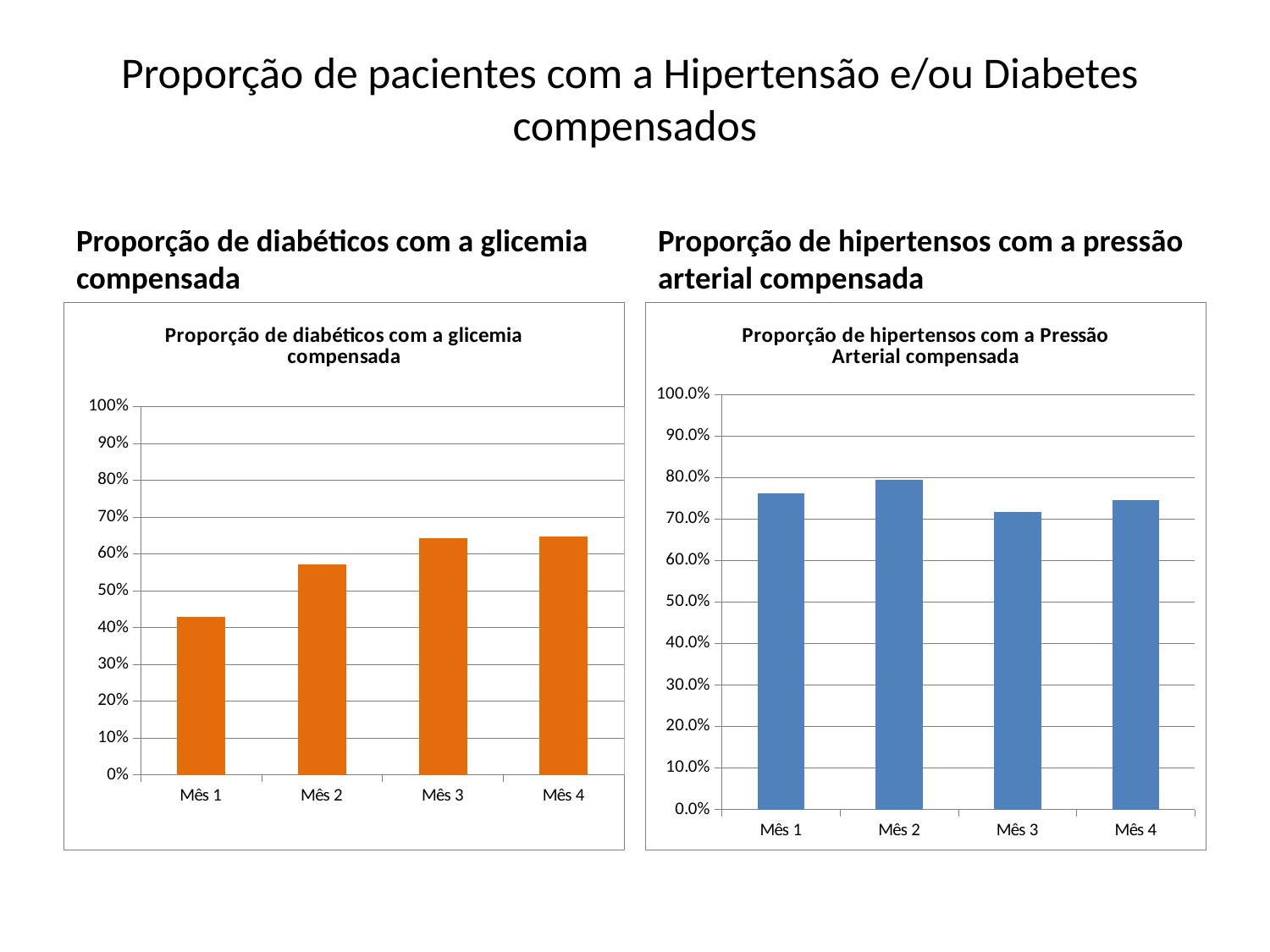
How many months are shown on the x axis of the right chart (Proporção de hipertensos com a Pressão Arterial compensada)? 4 On the left chart (Proporção de diabéticos com a glicemia compensada), which month has the lowest value? Mês 1 On the right chart (Proporção de hipertensos com a Pressão Arterial compensada), which month has the lowest value? Mês 3 On the left chart (Proporção de diabéticos com a glicemia compensada), is the value for Mês 2 greater or less than 50%? greater On the left chart (Proporção de diabéticos com a glicemia compensada), which is larger, the value for Mês 1 or the value for Mês 3? Mês 3 On the right chart (Proporção de hipertensos com a Pressão Arterial compensada), which month has the highest value? Mês 2 On the left chart (Proporção de diabéticos com a glicemia compensada), is the value for Mês 1 greater or less than 50%? less On the right chart (Proporção de hipertensos com a Pressão Arterial compensada), which is larger, the value for Mês 2 or the value for Mês 3? Mês 2 On the left chart (Proporção de diabéticos com a glicemia compensada), do the values rise or fall from Mês 1 to Mês 4? rise On the left chart (Proporção de diabéticos com a glicemia compensada), is the value for Mês 3 greater or less than 60%? greater